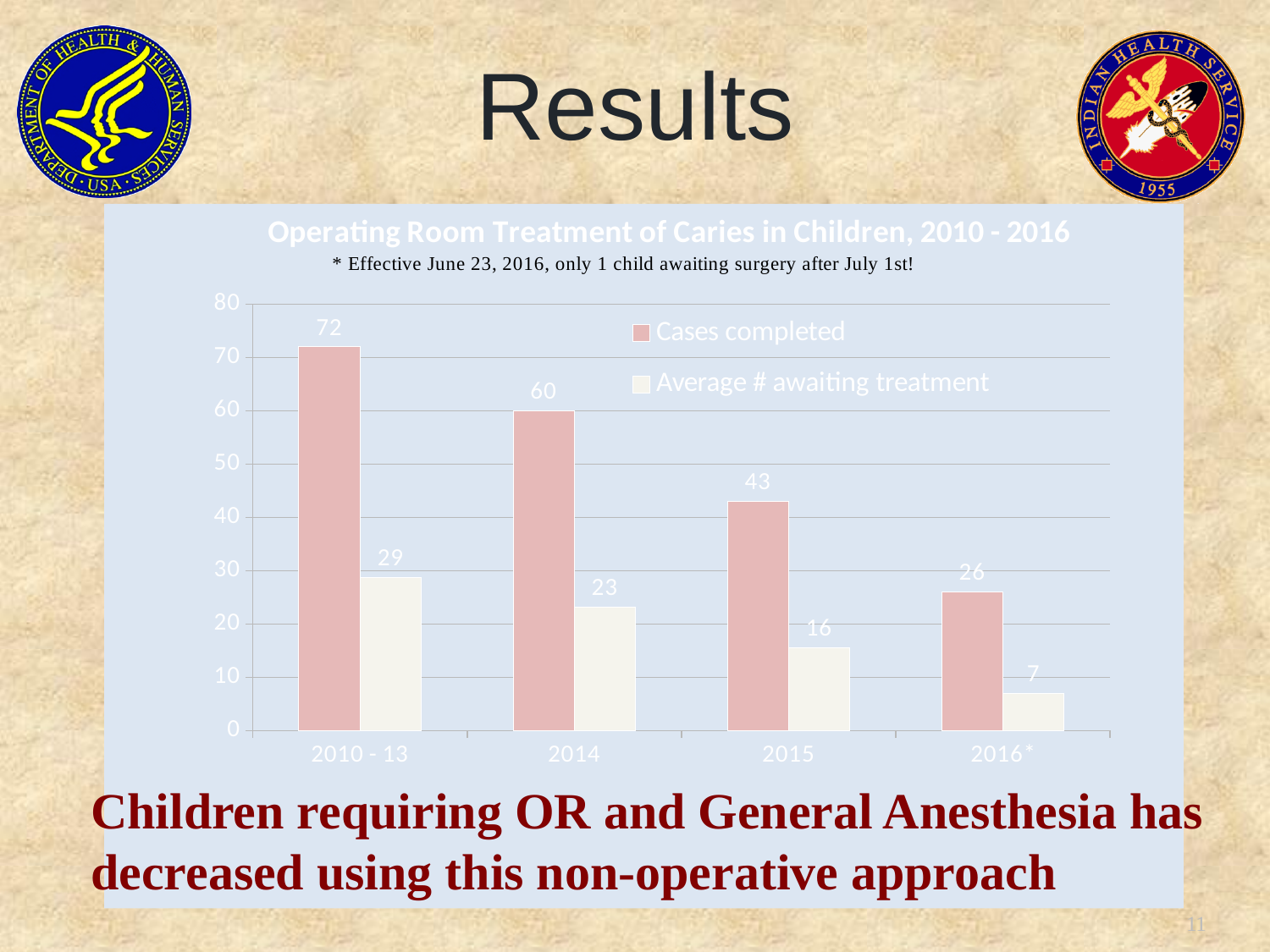
What is the value for Average # awaiting treatment in 2015? 16 How many categories are shown on the x axis? 4 What is the difference between Cases completed in 2014 and Cases completed in 2015? 17 Which category has the highest value for Cases completed? 2010 - 13 Do the values for Cases completed rise or fall from 2010 - 13 to 2016*? fall What is the value for Cases completed in 2010 - 13? 72 What is the title of the chart? Operating Room Treatment of Caries in Children, 2010 - 2016 What kind of chart is shown on the slide? bar chart How many series does the legend list? 2 What is the value for Cases completed in 2016*? 26 Which category has the lowest value for Average # awaiting treatment? 2016* Which is larger: Average # awaiting treatment in 2010 - 13 or Average # awaiting treatment in 2014? 2010 - 13